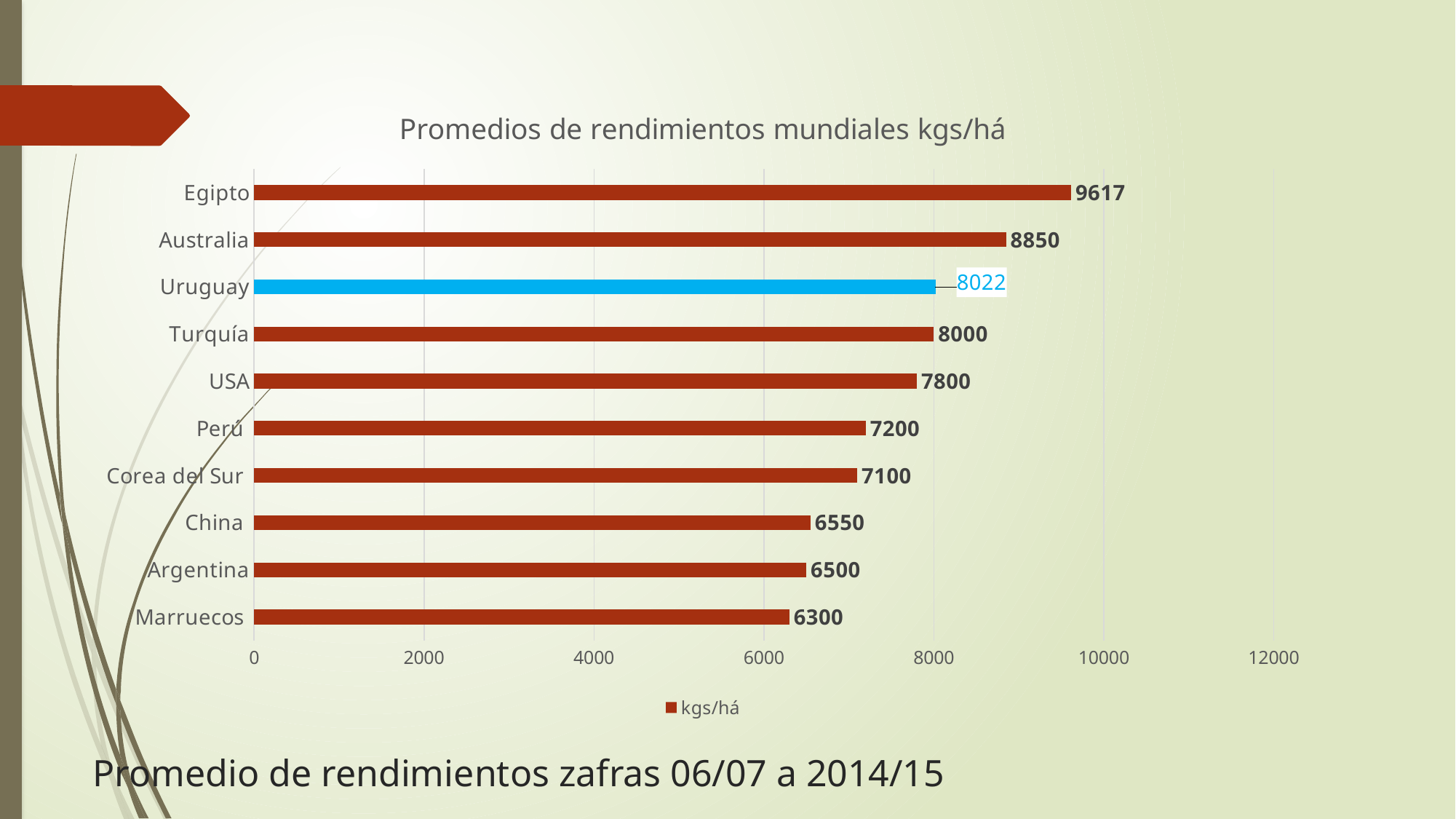
What is the value for Uruguay? 8022 What is the difference between the values for Egipto and Australia? 767 Which country has the highest value? Egipto What is the difference between the values for Uruguay and Turquía? 22 Which has a larger value, USA or Perú? USA What is the title of the chart? Promedios de rendimientos mundiales kgs/há What type of chart is shown? Bar chart Which country has the lowest value? Marruecos Is the value for China greater or less than 6000? greater How many countries are shown in the chart? 10 What is the value for Corea del Sur? 7100 What is the value for Egipto? 9617